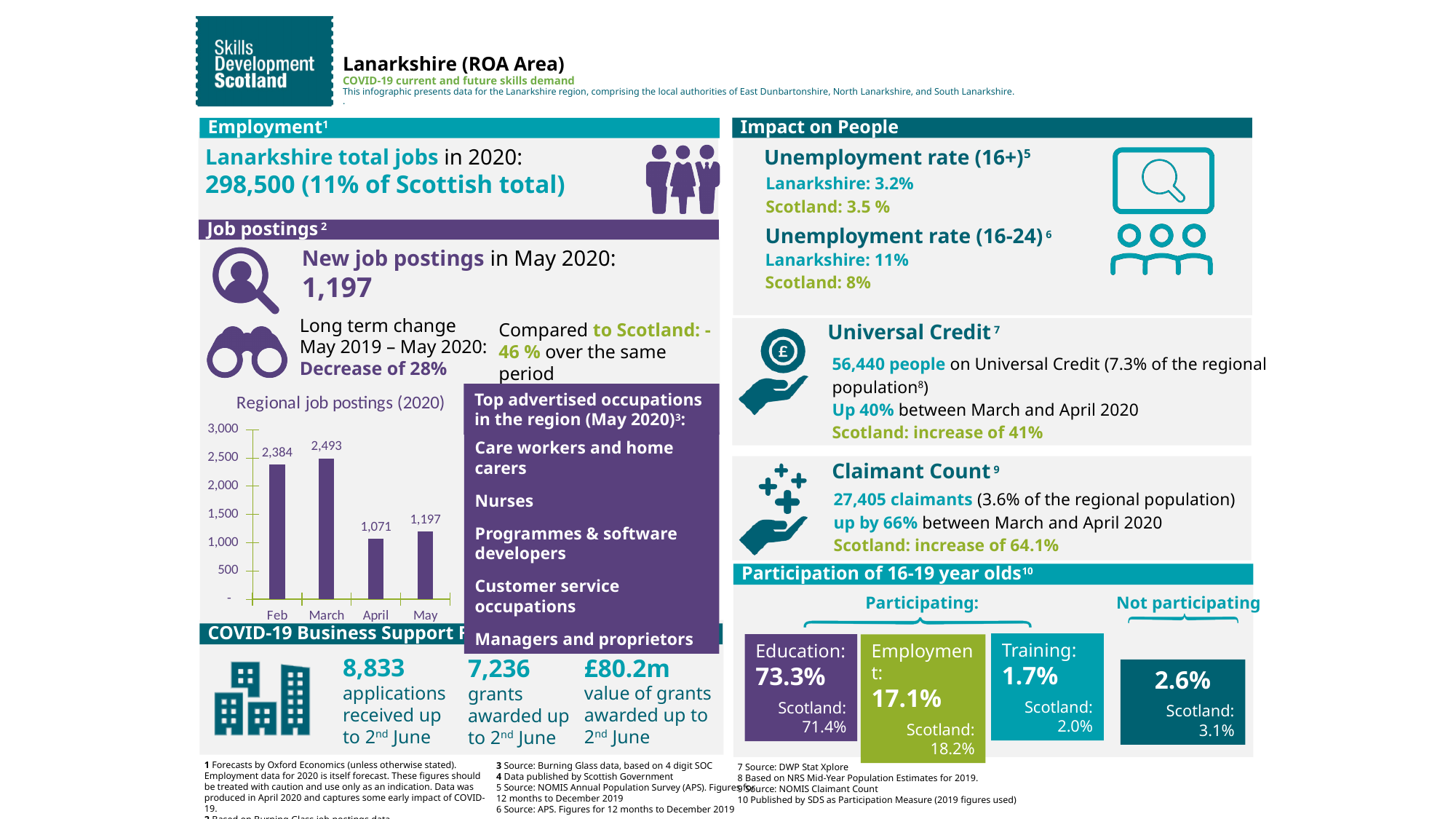
In the 'Regional job postings (2020)' chart, which month has the lowest number of job postings? April What type of chart is 'Regional job postings (2020)'? bar chart In the 'Regional job postings (2020)' chart, do the values rise or fall from March to April? fall In the 'Regional job postings (2020)' chart, is the value for April greater or less than 1,500? less In the 'Regional job postings (2020)' chart, what is the value for March? 2,493 In the 'Regional job postings (2020)' chart, what is the value for Feb? 2,384 In the 'Regional job postings (2020)' chart, which month has the highest number of job postings? March In the 'Regional job postings (2020)' chart, what is the difference between the March and April values? 1,422 In the 'Regional job postings (2020)' chart, what is the value for April? 1,071 How many months are shown in the 'Regional job postings (2020)' chart? 4 In the 'Regional job postings (2020)' chart, which is larger, the value for Feb or the value for May? Feb In the 'Regional job postings (2020)' chart, what is the difference between the Feb and May values? 1,187